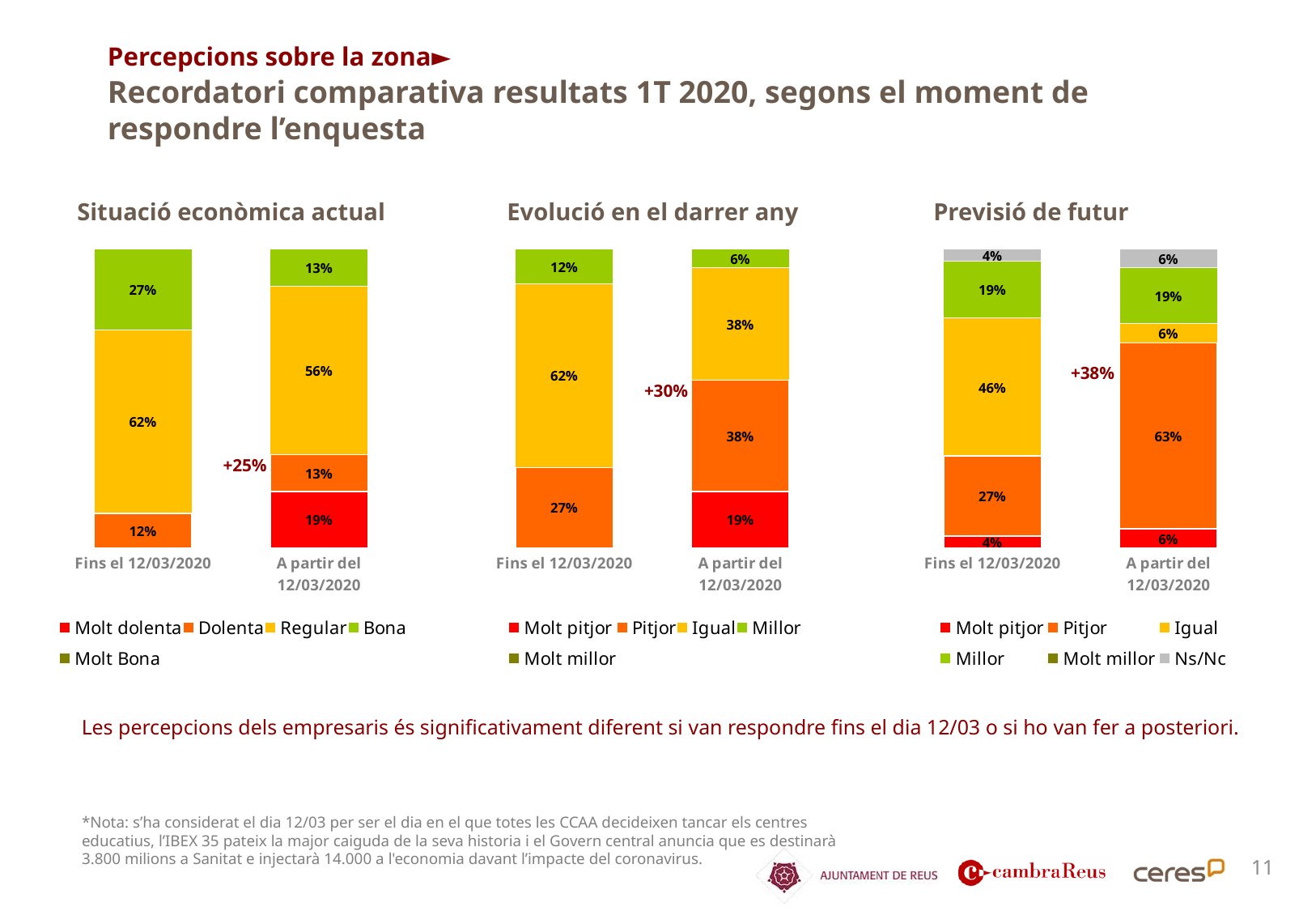
In the 'Evolució en el darrer any' chart, what is the value for Pitjor in the 'A partir del 12/03/2020' bar? 38% In the 'Previsió de futur' chart, what is the value for Igual in the 'Fins el 12/03/2020' bar? 46% What kind of chart is 'Situació econòmica actual'? Stacked bar chart In the 'Evolució en el darrer any' chart, which segment is largest in the 'Fins el 12/03/2020' bar? Igual In the 'Situació econòmica actual' chart, what is the difference between the Bona values for 'Fins el 12/03/2020' and 'A partir del 12/03/2020'? 14% In the 'Previsió de futur' chart, what is the difference between the Pitjor values for 'A partir del 12/03/2020' and 'Fins el 12/03/2020'? 36% In the 'Previsió de futur' chart, what is the value for Pitjor in the 'A partir del 12/03/2020' bar? 63% In the 'Evolució en el darrer any' chart, is the Millor value larger for 'Fins el 12/03/2020' or 'A partir del 12/03/2020'? Fins el 12/03/2020 In the 'Situació econòmica actual' chart, what is the value for Regular in the 'Fins el 12/03/2020' bar? 62% How many bars are shown in the 'Evolució en el darrer any' chart? 2 In the 'Situació econòmica actual' chart, what is the value for Molt dolenta in the 'A partir del 12/03/2020' bar? 19% How many series does the legend of the 'Previsió de futur' chart list? 6